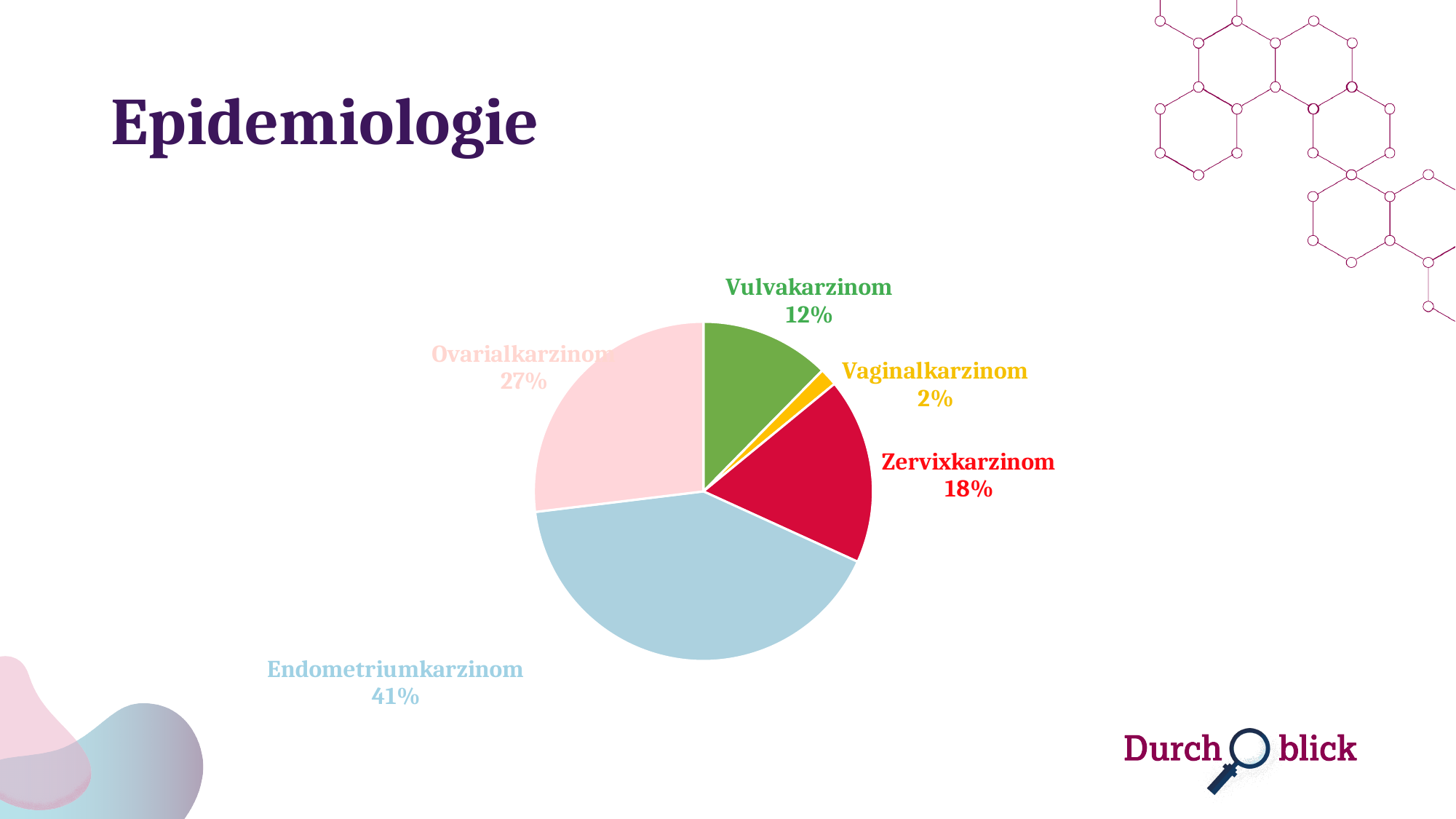
What share of the pie does Endometriumkarzinom have? 41% Which is larger, the share for Zervixkarzinom or the share for Vulvakarzinom? Zervixkarzinom How many categories are shown in the pie chart? 5 What share of the pie does Zervixkarzinom have? 18% Which category has the largest slice of the pie? Endometriumkarzinom What share of the pie does Ovarialkarzinom have? 27% Which category has the smallest slice of the pie? Vaginalkarzinom What type of chart is shown on the slide? pie chart What colour is the Zervixkarzinom slice? red What is the difference in percentage points between Endometriumkarzinom and Ovarialkarzinom? 14